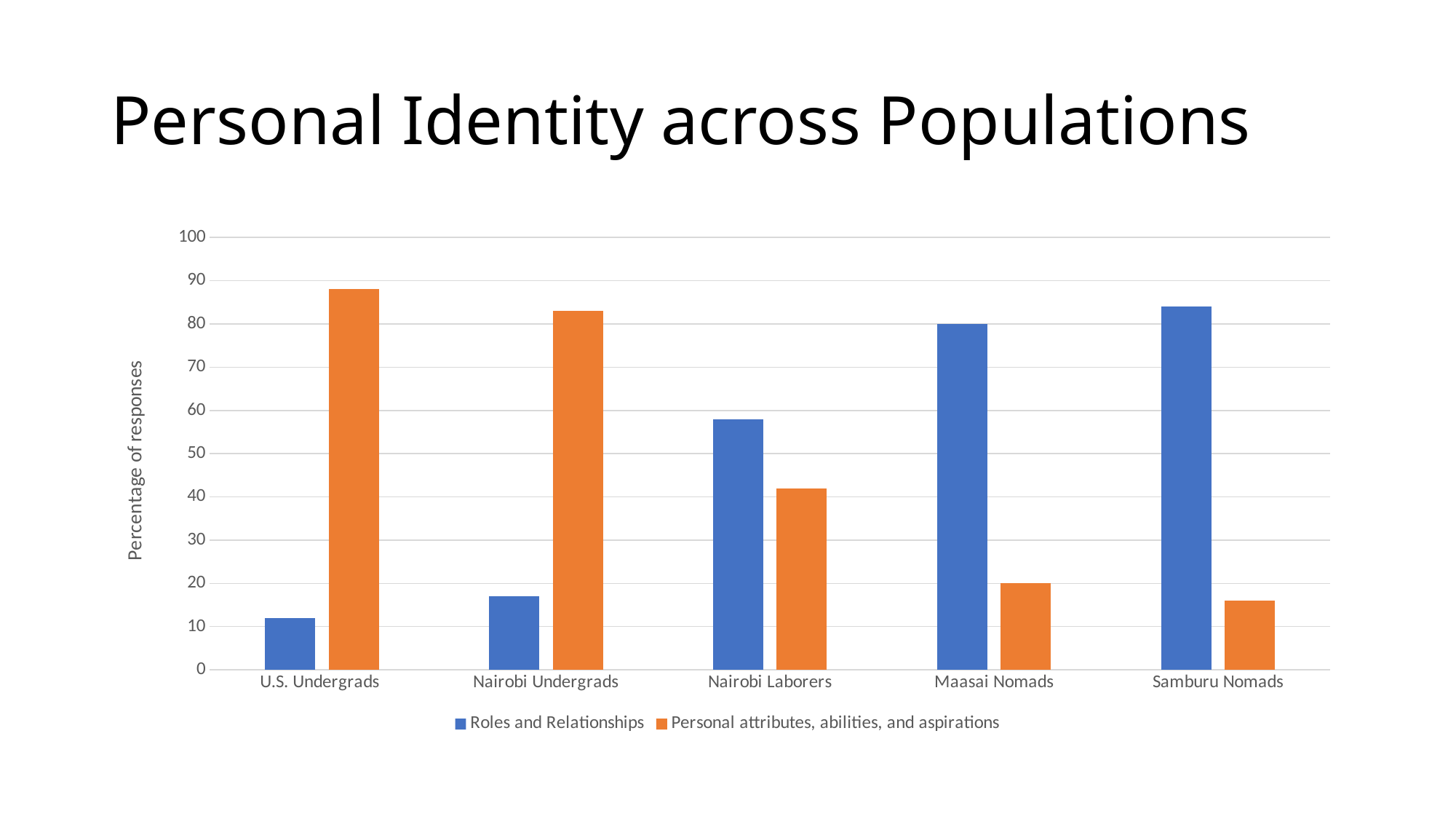
Which population has the lowest value for Roles and Relationships? U.S. Undergrads What is the label of the vertical axis? Percentage of responses How many series does the chart's legend list? 2 What is the title of the slide containing the chart? Personal Identity across Populations Which population has the highest value for Roles and Relationships? Samburu Nomads What is the value for Roles and Relationships for Maasai Nomads? 80 How many populations are shown on the x axis of the chart? 5 Is the value for Personal attributes, abilities, and aspirations for U.S. Undergrads greater or less than 80? greater What type of chart is shown on the slide? bar chart Is the value for Roles and Relationships for Nairobi Laborers greater or less than 50? greater For Nairobi Laborers, which is larger: Roles and Relationships or Personal attributes, abilities, and aspirations? Roles and Relationships Which population has the highest value for Personal attributes, abilities, and aspirations? U.S. Undergrads